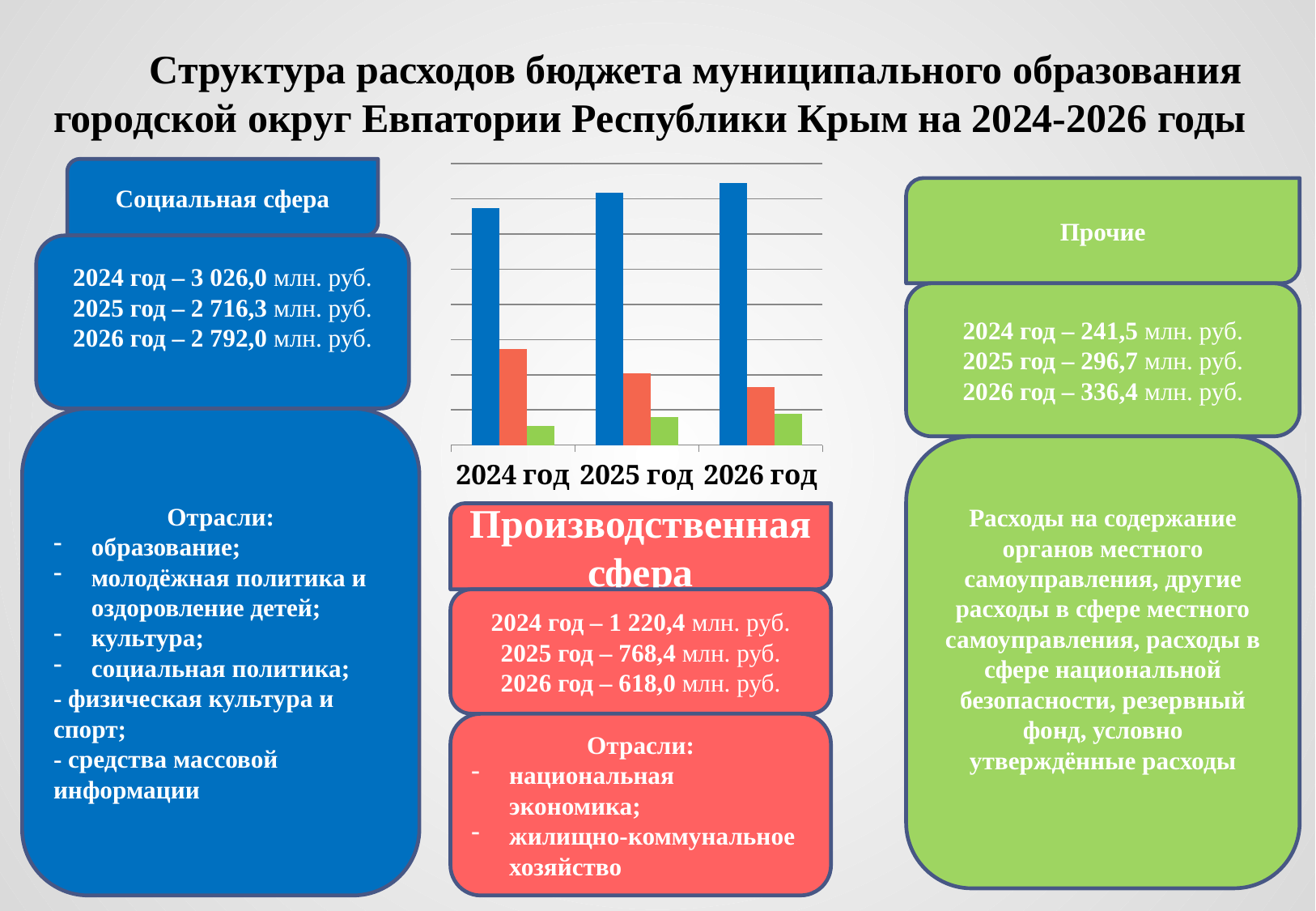
What kind of chart is shown on the slide? bar chart How many year categories are shown on the x axis of the chart? 3 How many bars are plotted for each year in the chart? 3 In which year is the green bar the shortest? 2024 год In which year is the red bar the tallest? 2024 год Do the red bars rise or fall from 2024 год to 2026 год? fall Do the blue bars rise or fall from 2024 год to 2026 год? rise In which year is the blue bar the tallest? 2026 год Which colour bar is the shortest in every year of the chart? green How many bars are plotted in total in the chart? 9 In which year is the red bar the shortest? 2026 год In 2025 год, which bar is taller, the blue one or the red one? the blue one